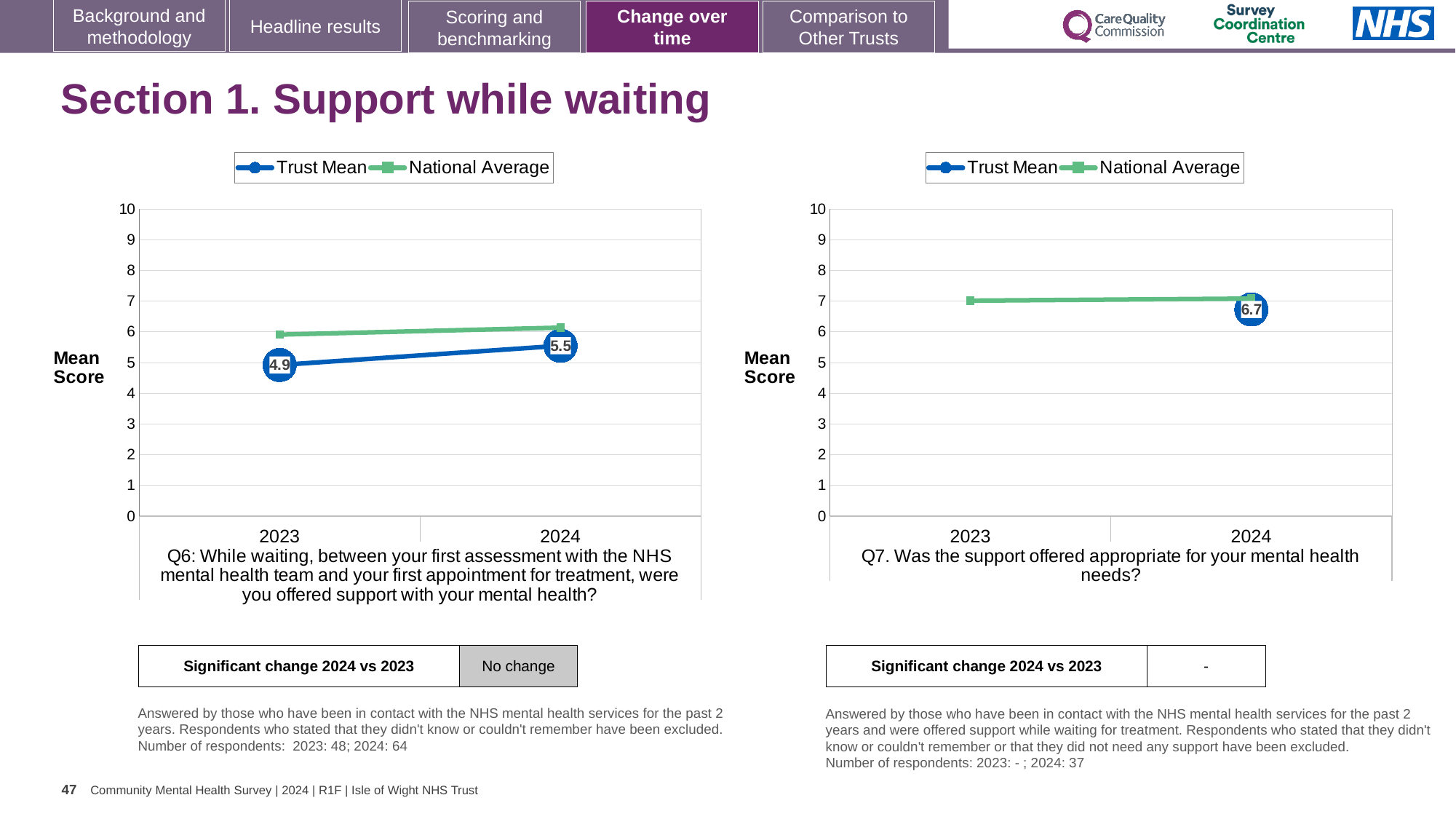
In the Q6 chart on the left, in 2024 which is higher, the Trust Mean or the National Average? National Average In the Q6 chart on the left, what is the Trust Mean for 2023? 4.9 How many series does the legend of the Q7 chart on the right list? 2 In the Q6 chart on the left, what is the Trust Mean for 2024? 5.5 How many years are shown on the x axis of the Q6 chart on the left? 2 In the Q6 chart on the left, by how much did the Trust Mean change from 2023 to 2024? 0.6 In the Q7 chart on the right, what is the Trust Mean for 2024? 6.7 In the Q6 chart on the left, which year has the higher Trust Mean, 2023 or 2024? 2024 In the Q7 chart on the right, is the National Average for 2023 greater or less than 6? greater In the Q6 chart on the left, is the National Average for 2023 greater or less than 5? greater In the Q6 chart on the left, does the Trust Mean rise or fall from 2023 to 2024? rise What kind of chart is the Q6 chart on the left? line chart